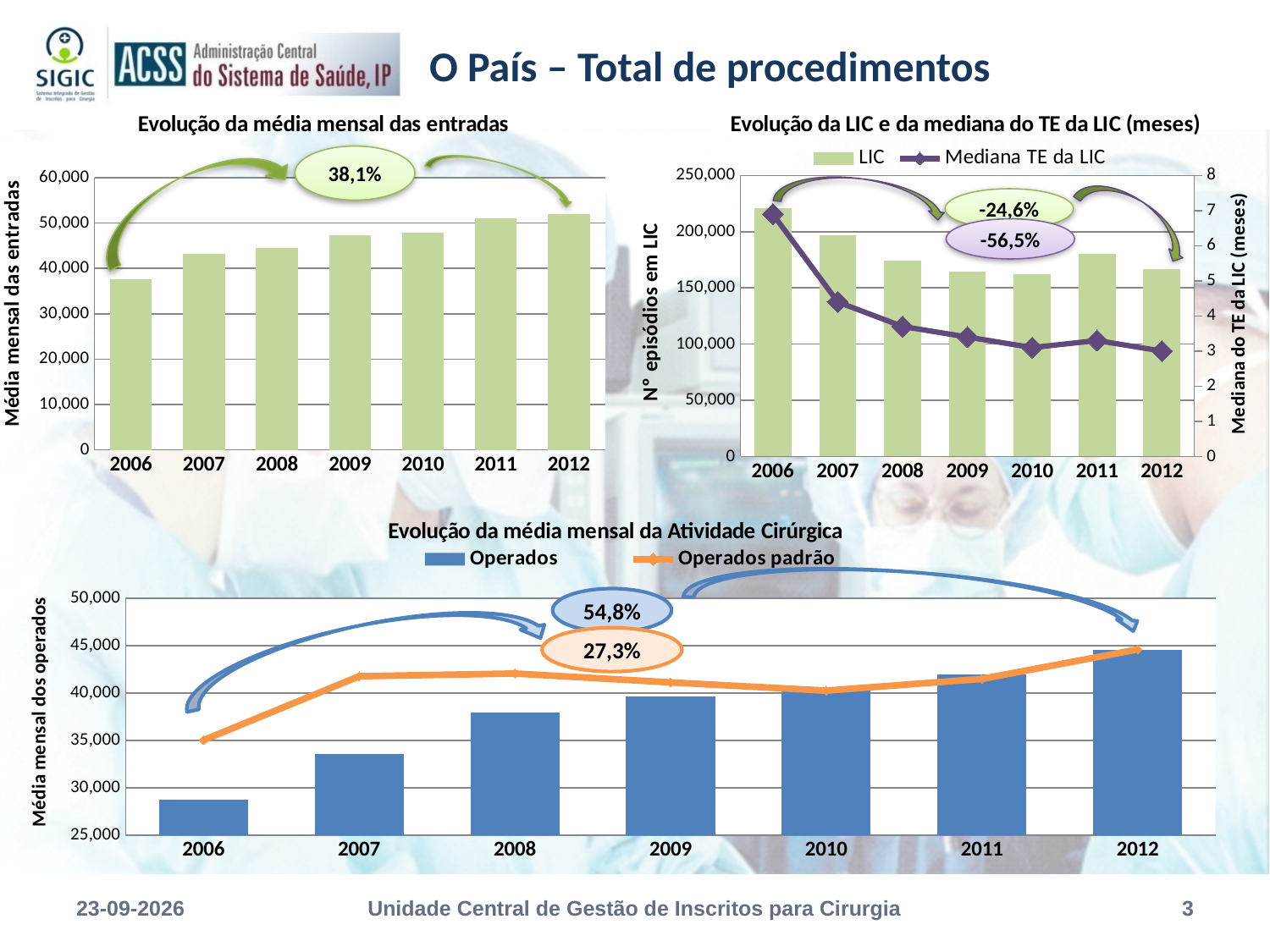
In the chart 'Evolução da média mensal da Atividade Cirúrgica', which is larger in 2007, Operados or Operados padrão? Operados padrão In the chart 'Evolução da média mensal das entradas', which year has the highest bar? 2012 In the chart 'Evolução da média mensal das entradas', what kind of chart is used? bar chart In the chart 'Evolução da LIC e da mediana do TE da LIC (meses)', how many series does the legend list? 2 In the chart 'Evolução da média mensal das entradas', what percentage is shown in the annotation bubble above the bars? 38,1% In the chart 'Evolução da média mensal da Atividade Cirúrgica', which year has the lowest Operados bar? 2006 In the chart 'Evolução da média mensal das entradas', how many years are shown on the x axis? 7 In the chart 'Evolução da LIC e da mediana do TE da LIC (meses)', is the LIC value for 2006 greater or less than 200,000? greater In the chart 'Evolução da média mensal das entradas', is the value for 2006 greater or less than 40,000? less In the chart 'Evolução da média mensal das entradas', which year has the lowest bar? 2006 In the chart 'Evolução da LIC e da mediana do TE da LIC (meses)', which year has the highest LIC bar? 2006 In the chart 'Evolução da LIC e da mediana do TE da LIC (meses)', does the Mediana TE da LIC line generally rise or fall from 2006 to 2012? fall